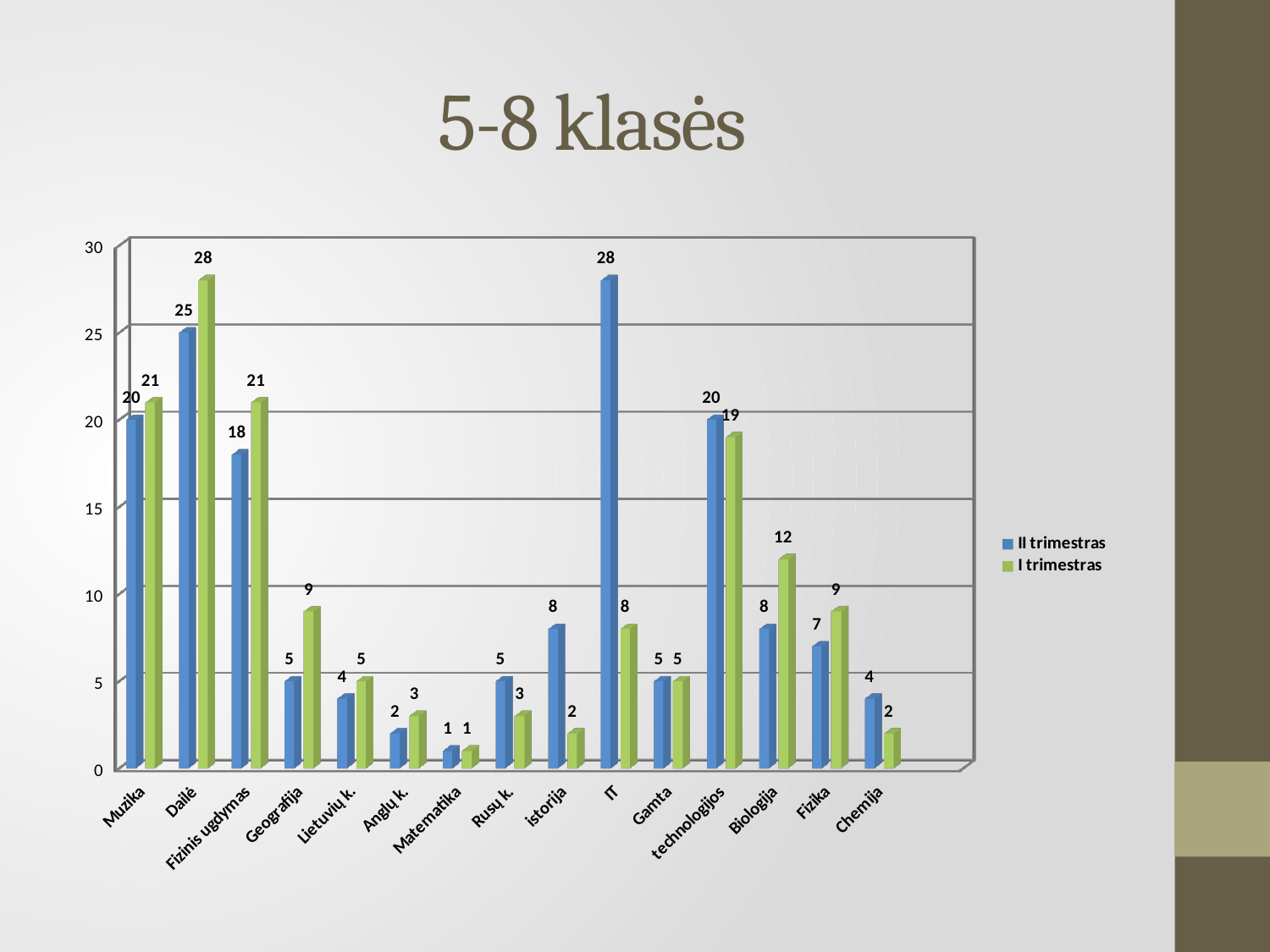
How many series does the legend list? 2 What is the value for Biologija in the I trimestras series? 12 What is the difference between the I trimestras and II trimestras values for Geografija? 4 How many categories are shown on the x axis? 15 What is the value for IT in the II trimestras series? 28 What is the difference between the I trimestras and II trimestras values for IT? 20 Which category has the lowest value in the II trimestras series? Matematika Which category has the highest value in the II trimestras series? IT Which category has the highest value in the I trimestras series? Dailė What type of chart is shown on the slide? Bar chart For istorija, which series has the larger value, II trimestras or I trimestras? II trimestras What is the value for Dailė in the II trimestras series? 25